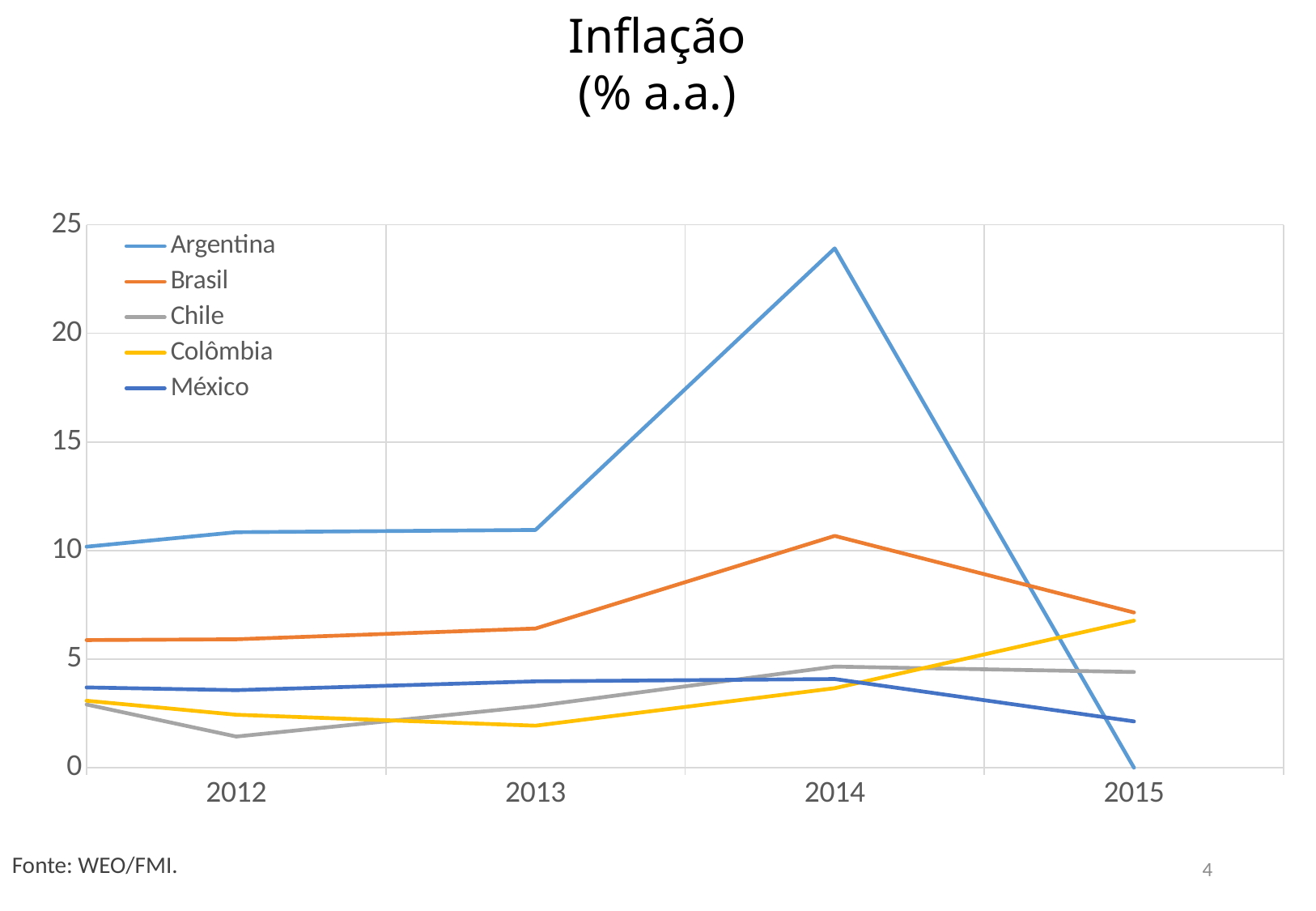
What kind of chart is shown on the slide? line chart Does the Brasil line rise or fall from 2012 to 2014? rise Is the value for Colômbia in 2013 greater or less than 5? less Which is larger in 2013, the value for Brasil or the value for México? Brasil How many series does the legend list? 5 Which country has the highest inflation in 2014? Argentina What is the title of the chart? Inflação (% a.a.) How many years are shown on the x axis? 4 Which is larger in 2015, the value for Colômbia or the value for Chile? Colômbia Which country has the lowest inflation in 2012? Chile Is the value for Brasil in 2014 greater or less than 10? greater Is the value for Argentina in 2014 greater or less than 20? greater